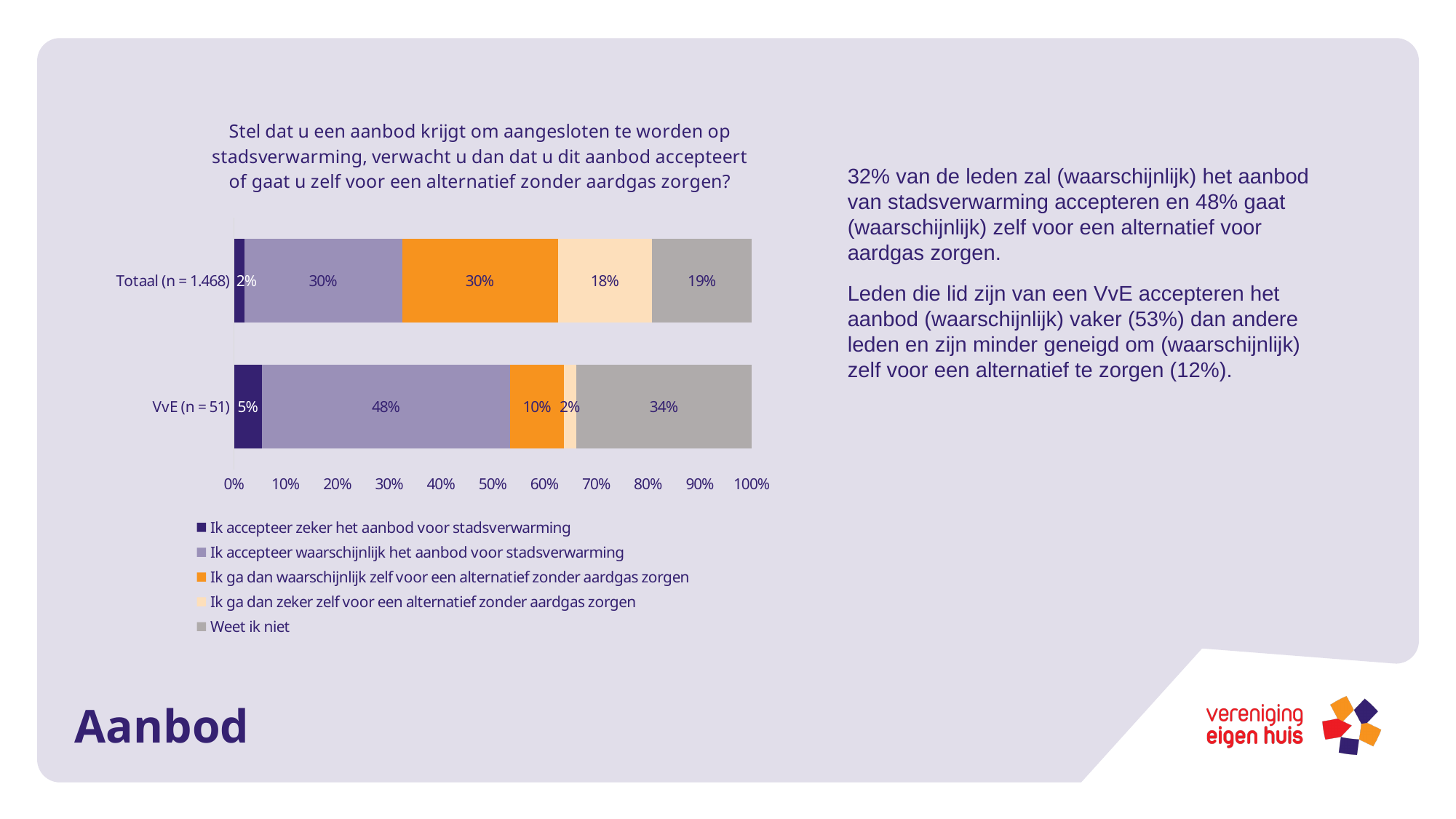
What is the difference between the 'Weet ik niet' values for VvE (n = 51) and Totaal (n = 1.468)? 15% What is the value for 'Ik accepteer waarschijnlijk het aanbod voor stadsverwarming' in the VvE (n = 51) bar? 48% What is the value for 'Ik accepteer zeker het aanbod voor stadsverwarming' in the VvE (n = 51) bar? 5% What kind of chart is shown on the slide? Stacked bar chart Which segment is the largest in the VvE (n = 51) bar? Ik accepteer waarschijnlijk het aanbod voor stadsverwarming What is the value for 'Ik ga dan zeker zelf voor een alternatief zonder aardgas zorgen' in the Totaal (n = 1.468) bar? 18% Which bar has the larger value for 'Ik ga dan waarschijnlijk zelf voor een alternatief zonder aardgas zorgen', Totaal (n = 1.468) or VvE (n = 51)? Totaal (n = 1.468) How many categories (bars) are shown in the chart? 2 How many series does the legend list? 5 What colour represents 'Weet ik niet' in the chart? Grey Which segment is the smallest in the Totaal (n = 1.468) bar? Ik accepteer zeker het aanbod voor stadsverwarming What is the value for 'Weet ik niet' in the Totaal (n = 1.468) bar? 19%